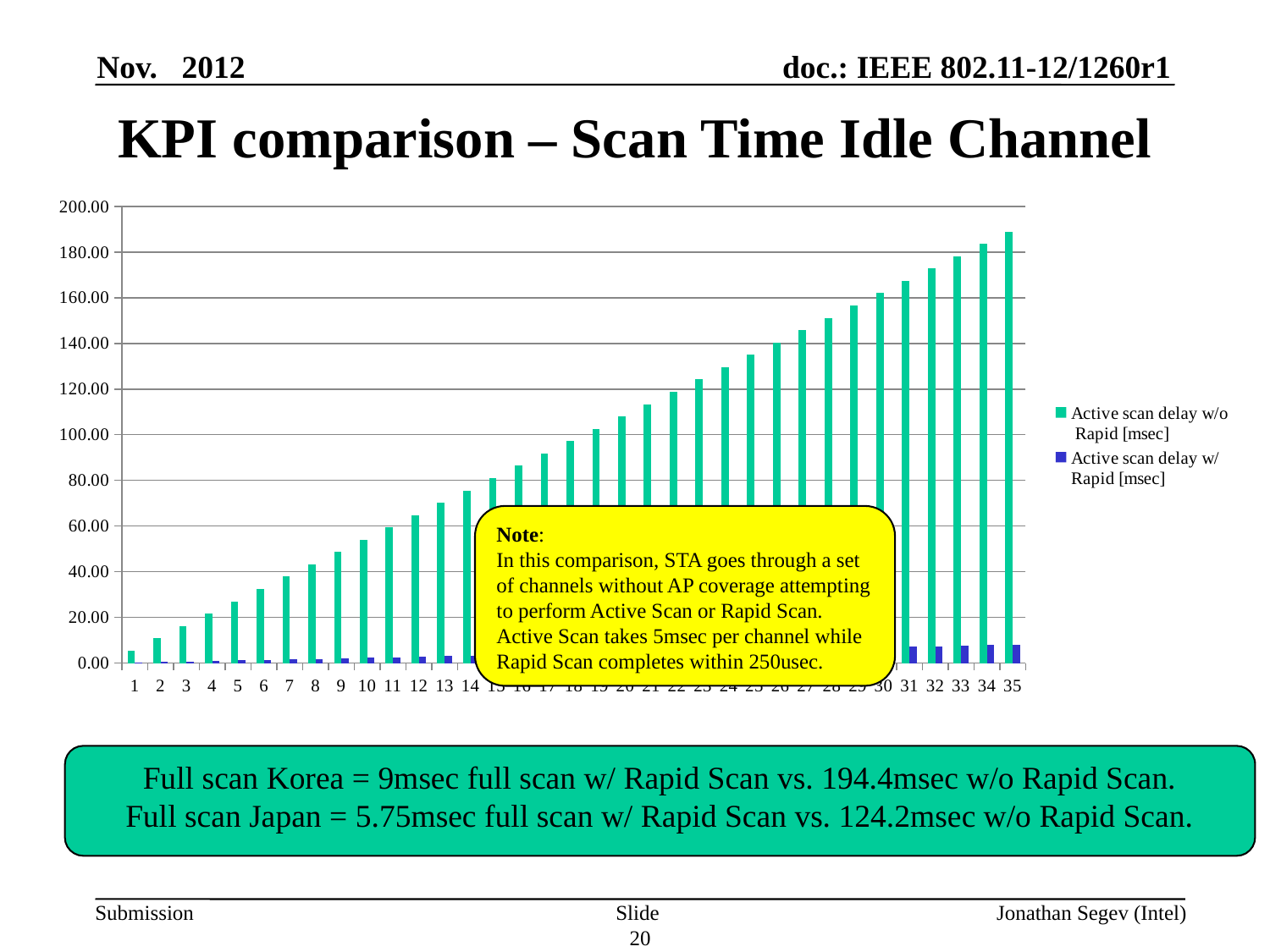
Which is larger at category 35: Active scan delay w/o Rapid [msec] or Active scan delay w/ Rapid [msec]? Active scan delay w/o Rapid [msec] Is the value for Active scan delay w/o Rapid [msec] at category 20 greater or less than 100? greater Is the value for Active scan delay w/o Rapid [msec] at category 1 greater or less than 20? less Is the value for Active scan delay w/o Rapid [msec] at category 10 greater or less than 60? less How many categories are shown along the x axis of the chart? 35 Which category has the lowest value for Active scan delay w/o Rapid [msec]? 1 How many series does the chart legend list? 2 What kind of chart is shown on the slide? bar chart Do the values for Active scan delay w/o Rapid [msec] rise or fall as the category number increases along the x axis? rise What colour are the bars for Active scan delay w/ Rapid [msec]? blue Which category has the highest value for Active scan delay w/o Rapid [msec]? 35